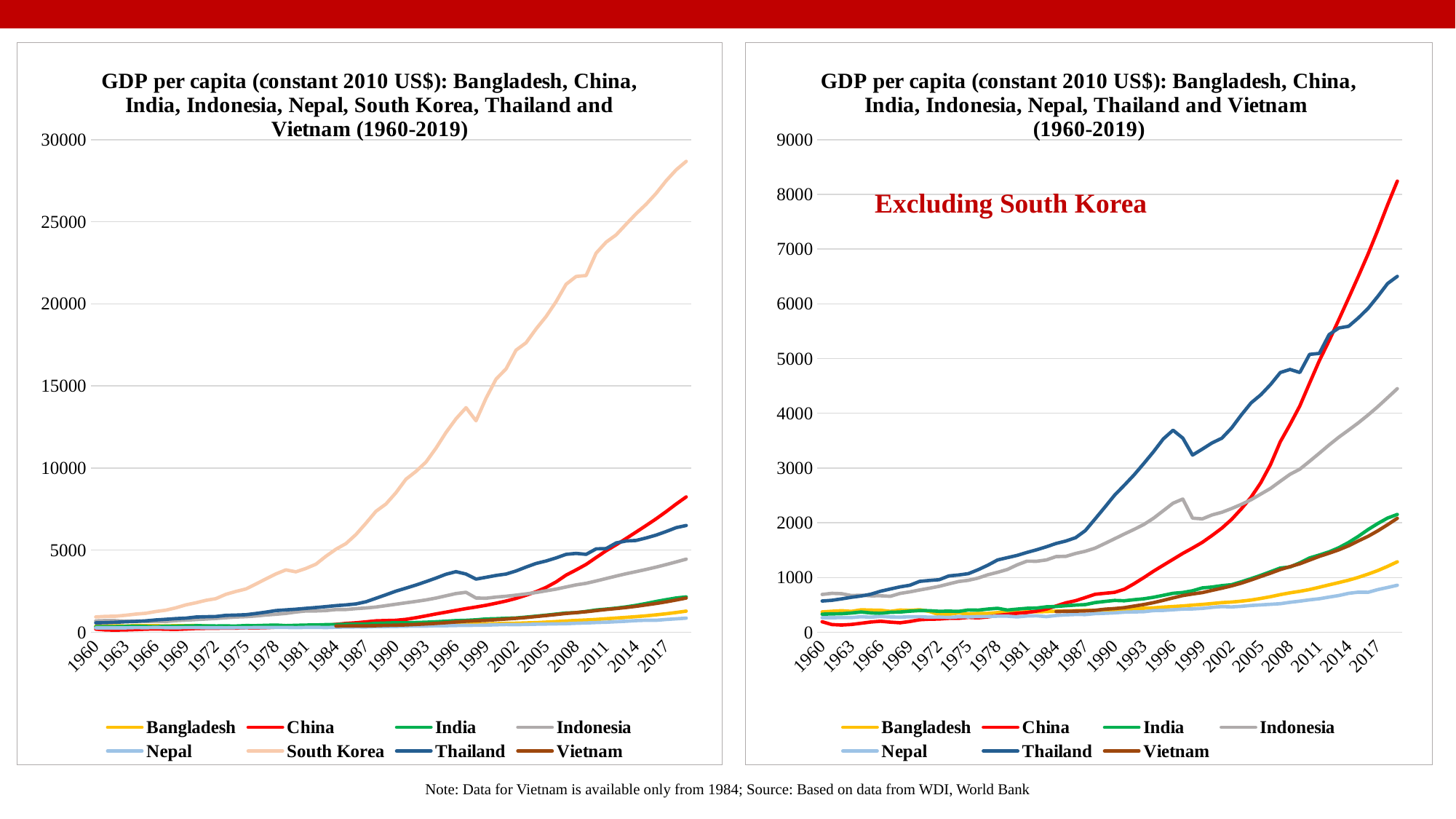
In the right chart (Excluding South Korea), is the value for Nepal in 2019 greater or less than 1000? less In the right chart (Excluding South Korea), which country has the lowest GDP per capita in 2019? Nepal In the right chart (Excluding South Korea), which country has the highest GDP per capita in 2019? China In the left chart, does the South Korea line generally rise or fall from 1960 to 2019? rise In the right chart (Excluding South Korea), is the value for Thailand in 2019 greater or less than 6000? greater How many series does the legend of the right chart (Excluding South Korea) list? 7 In the left chart, is the value for South Korea in 2019 greater or less than 25000? greater Which country appears in the legend of the left chart but not in the legend of the right chart? South Korea What kind of chart is the left chart, titled 'GDP per capita (constant 2010 US$): Bangladesh, China, India, Indonesia, Nepal, South Korea, Thailand and Vietnam (1960-2019)'? line chart In the left chart, which country has the highest GDP per capita in 2019? South Korea How many series does the legend of the left chart list? 8 In the right chart (Excluding South Korea), which is larger in 2019: Thailand or Indonesia? Thailand